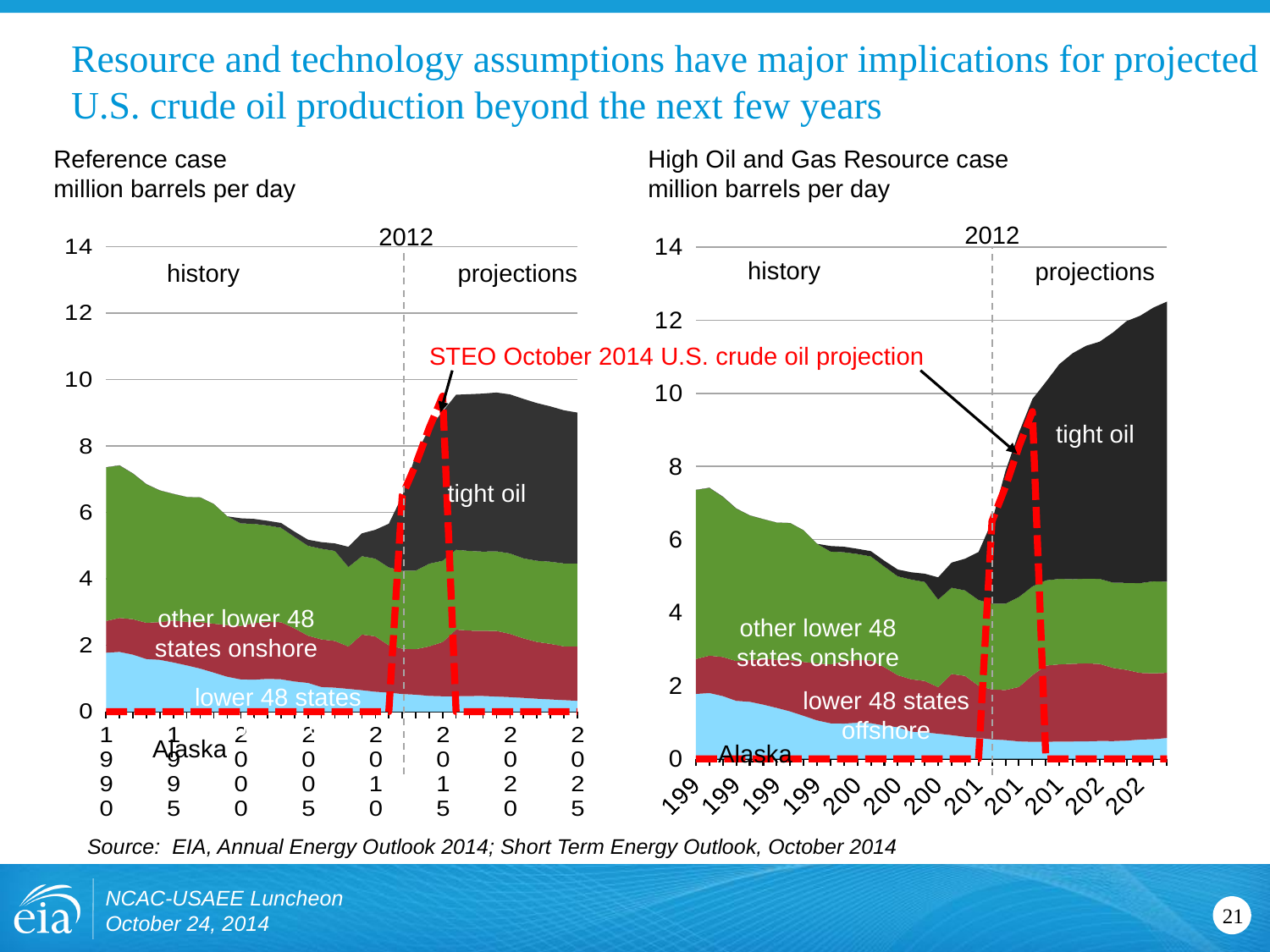
What is the highest value shown on the y-axis of the Reference case chart? 14 In the High Oil and Gas Resource case chart, is the total crude oil production at the end of the projection (2025) greater or less than 10 million barrels per day? greater Which chart shows the higher total U.S. crude oil production in 2025, the Reference case or the High Oil and Gas Resource case? High Oil and Gas Resource case In the Reference case chart, is the total U.S. crude oil production in 2025 greater or less than 8 million barrels per day? greater In the Reference case chart, is the total crude oil production in 1990 greater or less than 8 million barrels per day? less In the Reference case chart, does total crude oil production rise or fall between 1990 and 2005? fall What kind of chart is the Reference case chart on the left? stacked area chart What does the red dashed line on the charts represent? STEO October 2014 U.S. crude oil projection Which year does the vertical dashed line separating history from projections mark in both charts? 2012 How many production source areas are stacked in the Reference case chart? 4 In the High Oil and Gas Resource case chart, does total crude oil production rise or fall between 2012 and 2025? rise